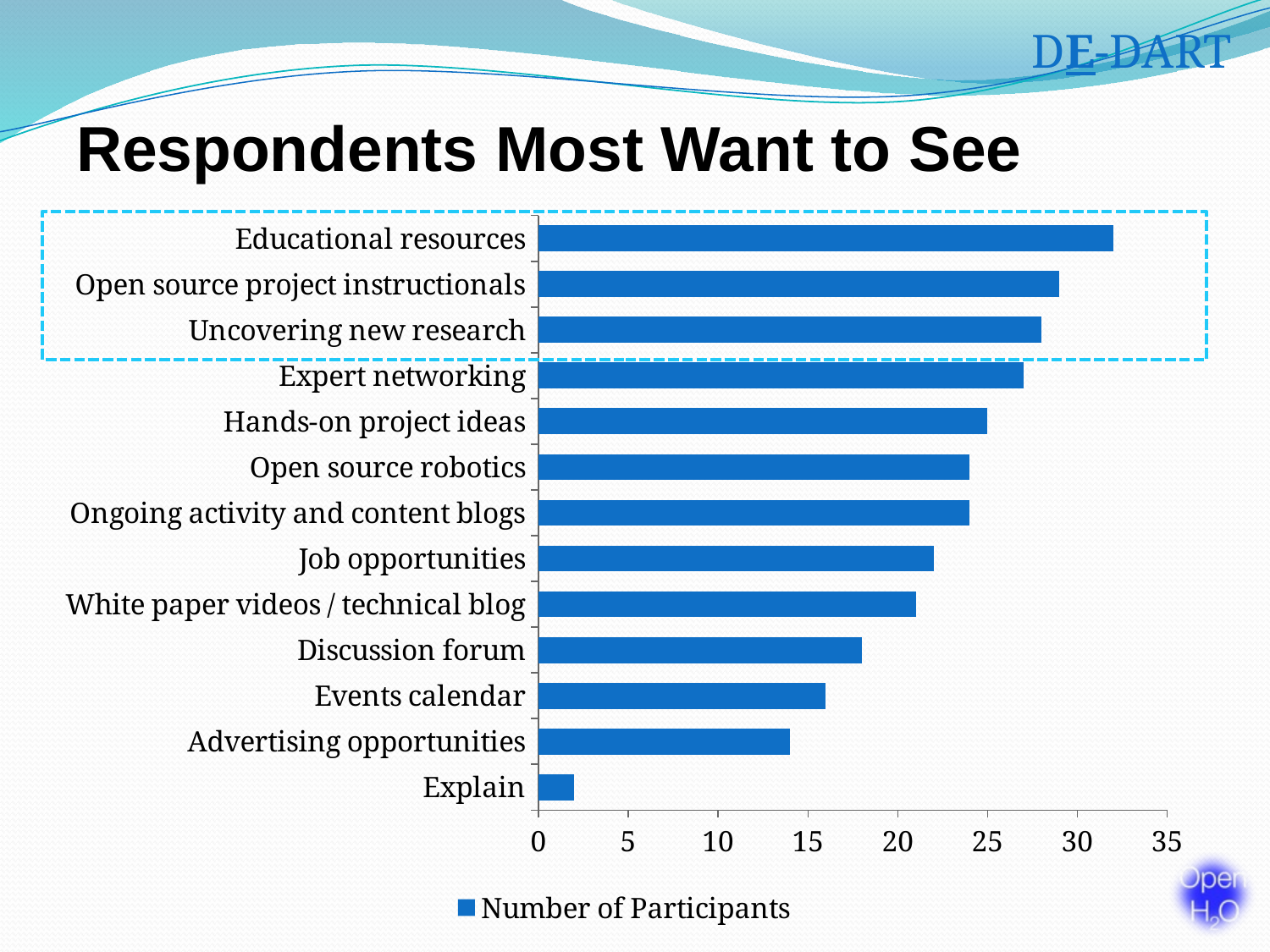
What series name is shown in the chart legend? Number of Participants Which category has the highest value? Educational resources How many series does the legend list? 1 Is the value for Educational resources greater or less than 30? greater Which category has the lowest value? Explain Which is larger, the value for Educational resources or the value for Advertising opportunities? Educational resources How many categories are plotted in the chart? 13 Which is larger, the value for Discussion forum or the value for Expert networking? Expert networking What kind of chart is shown on the slide? bar chart Is the value for Discussion forum greater or less than 20? less Is the value for Explain greater or less than 5? less